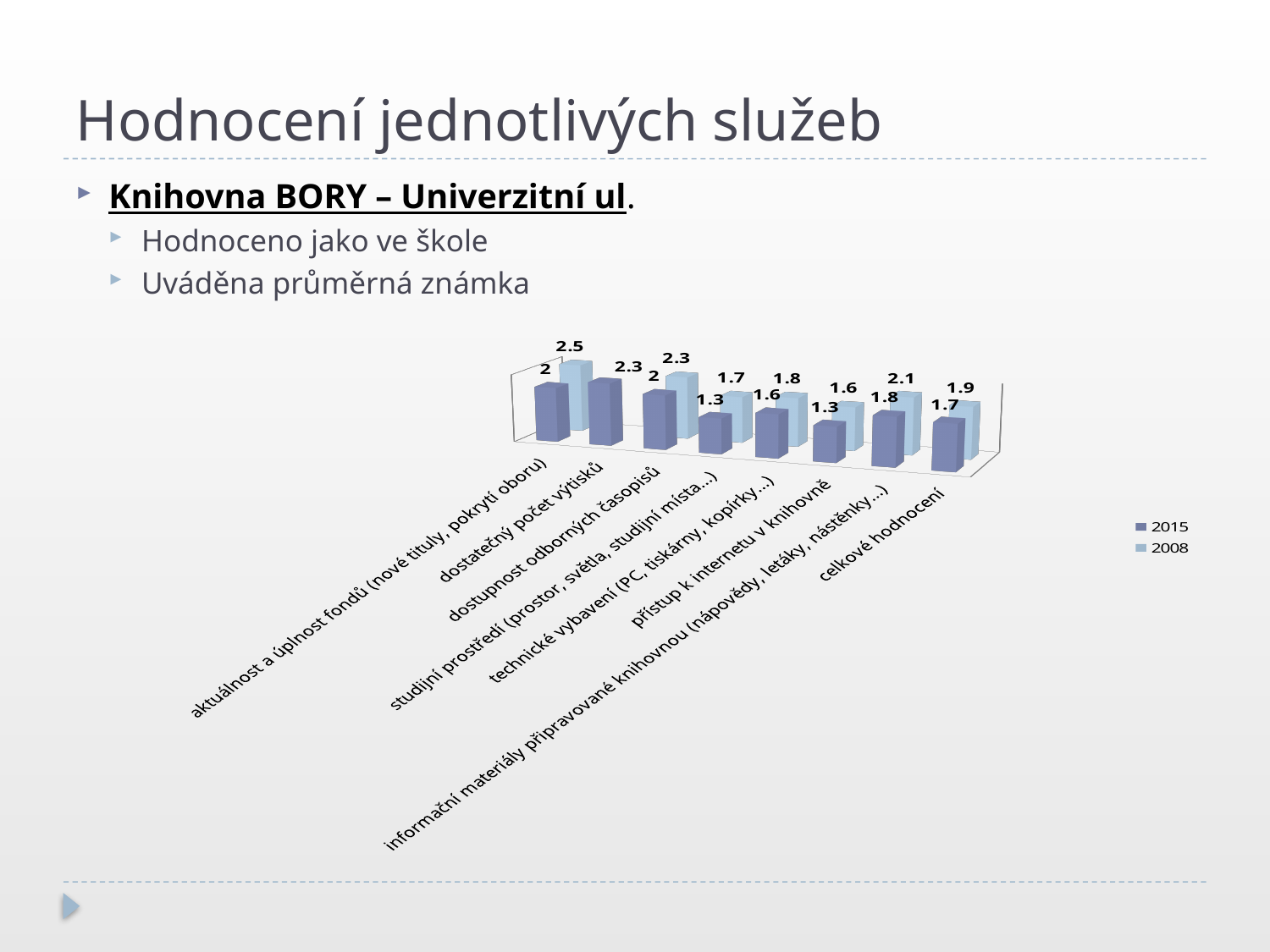
Which years are listed in the chart legend? 2015 and 2008 For 'technické vybavení (PC, tiskárny, kopírky...)', which series has the larger value, 2015 or 2008? 2008 What is the difference between the 2008 and 2015 values for 'celkové hodnocení'? 0.2 What kind of chart is shown on the slide? bar chart How many categories are shown on the chart's x axis? 8 What is the 2008 value for 'informační materiály připravované knihovnou (nápovědy, letáky, nástěnky...)'? 2.1 Which category has the highest 2008 value? aktuálnost a úplnost fondů (nové tituly, pokrytí oboru) What is the 2008 value for 'aktuálnost a úplnost fondů (nové tituly, pokrytí oboru)'? 2.5 What is the 2015 value for 'celkové hodnocení'? 1.7 What is the 2008 value for 'celkové hodnocení'? 1.9 How many series does the chart legend list? 2 What is the 2015 value for 'přístup k internetu v knihovně'? 1.3